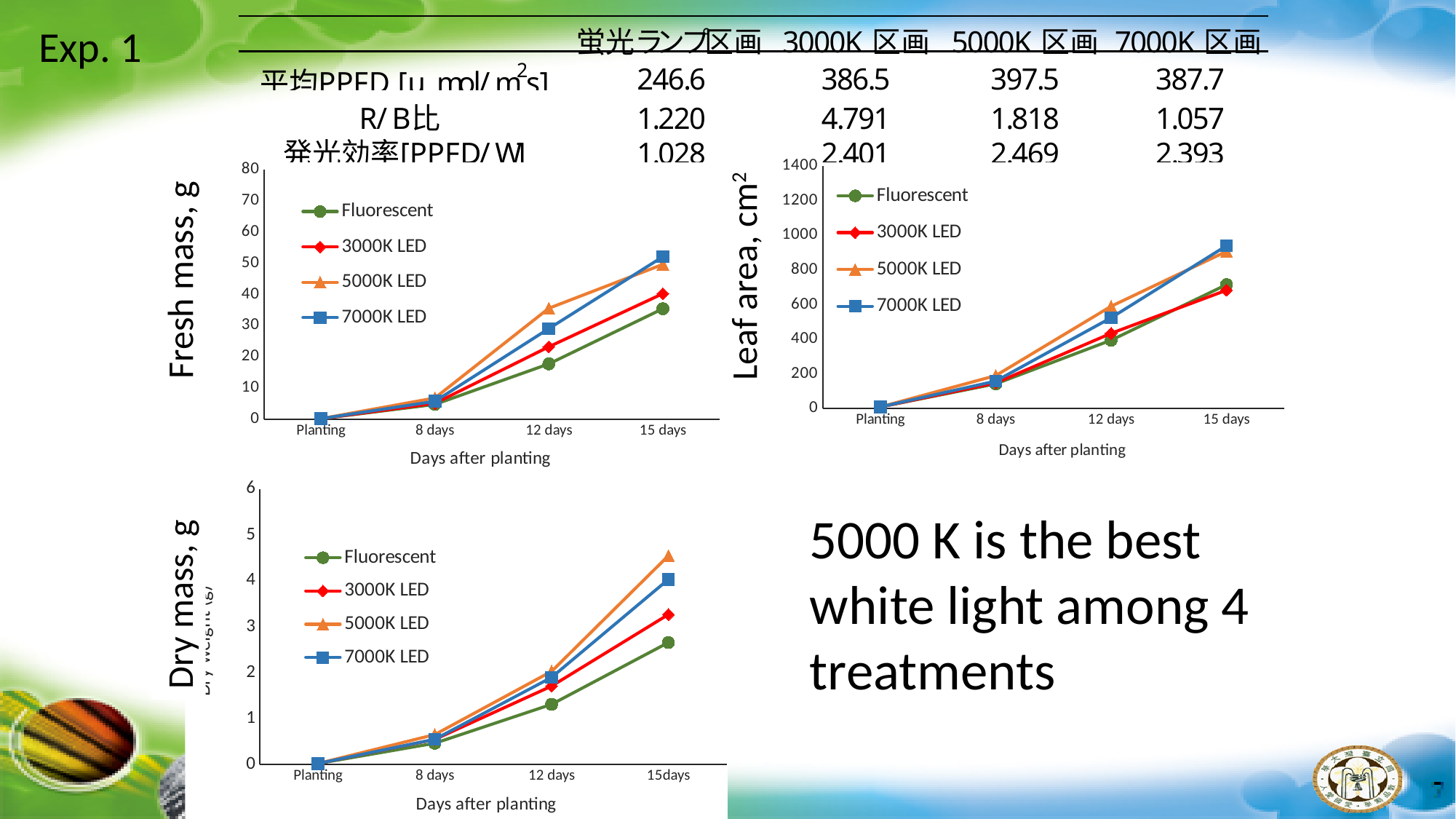
In the Dry mass chart, which series is highest at 15 days? 5000K LED In the Leaf area chart, is the value for 7000K LED at 15 days greater or less than 800? greater How many series does the legend of the Leaf area chart list? 4 In the Fresh mass chart, which series is lowest at 15 days? Fluorescent What type of chart is the Fresh mass chart? line chart In the Dry mass chart, is the value for 5000K LED at 15 days greater or less than 4? greater In the Fresh mass chart, is the value for Fluorescent at 15 days greater or less than 40? less In the Leaf area chart, do the values for 5000K LED rise or fall from Planting to 15 days? rise How many points along the x axis does the Dry mass chart have? 4 In the Dry mass chart, which series is lowest at 15 days? Fluorescent What is the y-axis label of the Leaf area chart? Leaf area, cm² In the Fresh mass chart, at 12 days, which is larger: 5000K LED or 3000K LED? 5000K LED